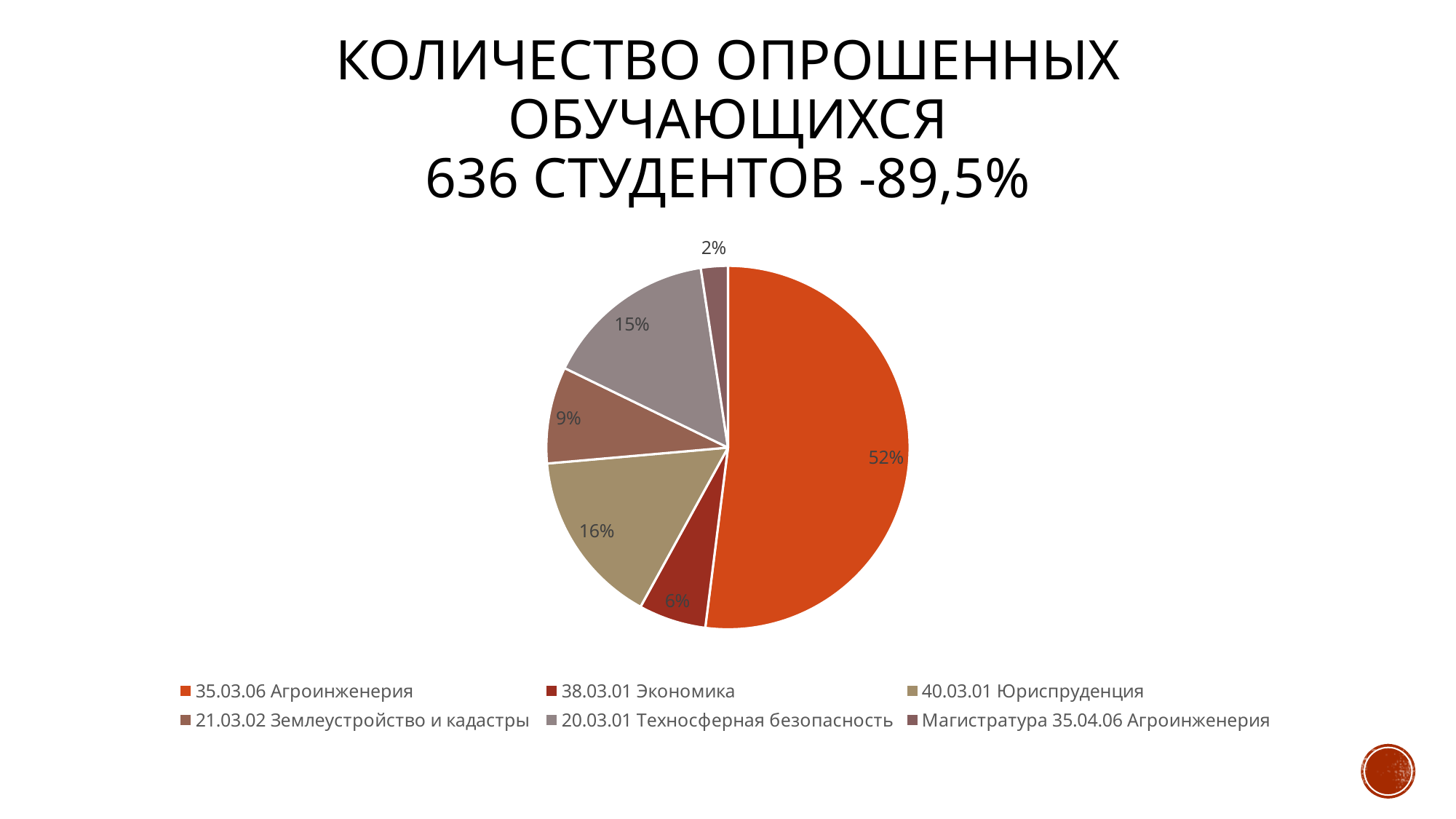
What kind of chart is shown on the slide? pie chart Which category has the largest slice of the pie? 35.03.06 Агроинженерия What share of the pie does 35.03.06 Агроинженерия have? 52% Which is larger: the share of 21.03.02 Землеустройство и кадастры or the share of 38.03.01 Экономика? 21.03.02 Землеустройство и кадастры What total number of students is stated in the slide title? 636 What is the difference between the shares of 40.03.01 Юриспруденция and 21.03.02 Землеустройство и кадастры? 7% How many entries does the legend list? 6 What is the value shown for 38.03.01 Экономика? 6% How many slices does the pie chart have? 6 What is the value shown for 20.03.01 Техносферная безопасность? 15% What is the value shown for 40.03.01 Юриспруденция? 16% Which category has the smallest slice of the pie? Магистратура 35.04.06 Агроинженерия